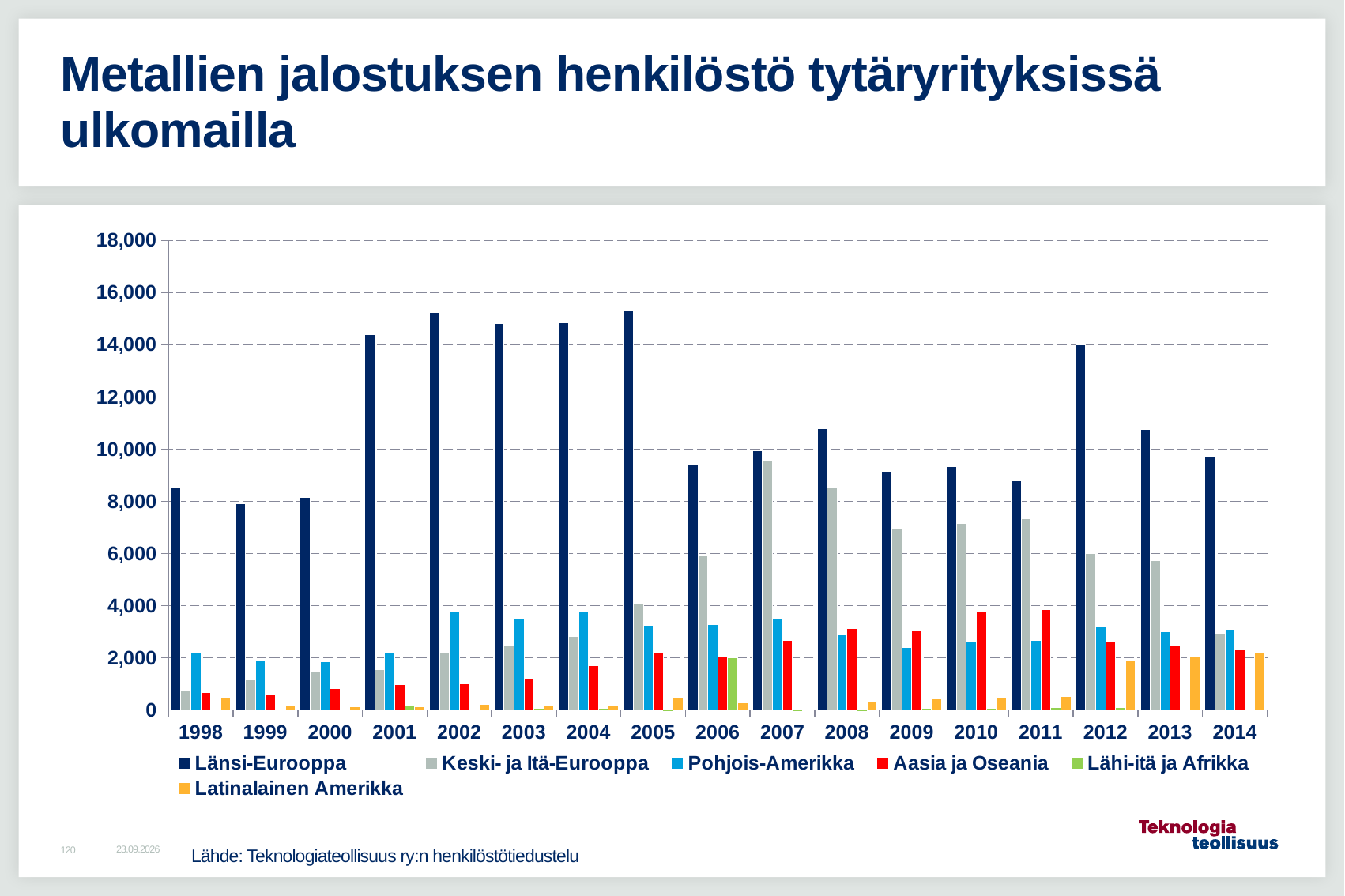
In which year is the value for Lähi-itä ja Afrikka highest? 2006 How many series does the legend list? 6 In 2011, which is larger: Pohjois-Amerikka or Aasia ja Oseania? Aasia ja Oseania Is the value for Aasia ja Oseania in 2010 greater or less than 3,000? greater In 2008, which is larger: Länsi-Eurooppa or Keski- ja Itä-Eurooppa? Länsi-Eurooppa Does the value for Keski- ja Itä-Eurooppa rise or fall from 1998 to 2007? Rise In which year is the value for Keski- ja Itä-Eurooppa highest? 2007 In which year is the value for Latinalainen Amerikka highest? 2014 What kind of chart is shown on the slide? Bar chart Is the value for Länsi-Eurooppa in 2001 greater or less than 14,000? greater Is the value for Keski- ja Itä-Eurooppa in 2009 greater or less than 6,000? greater How many years are shown on the x axis? 17